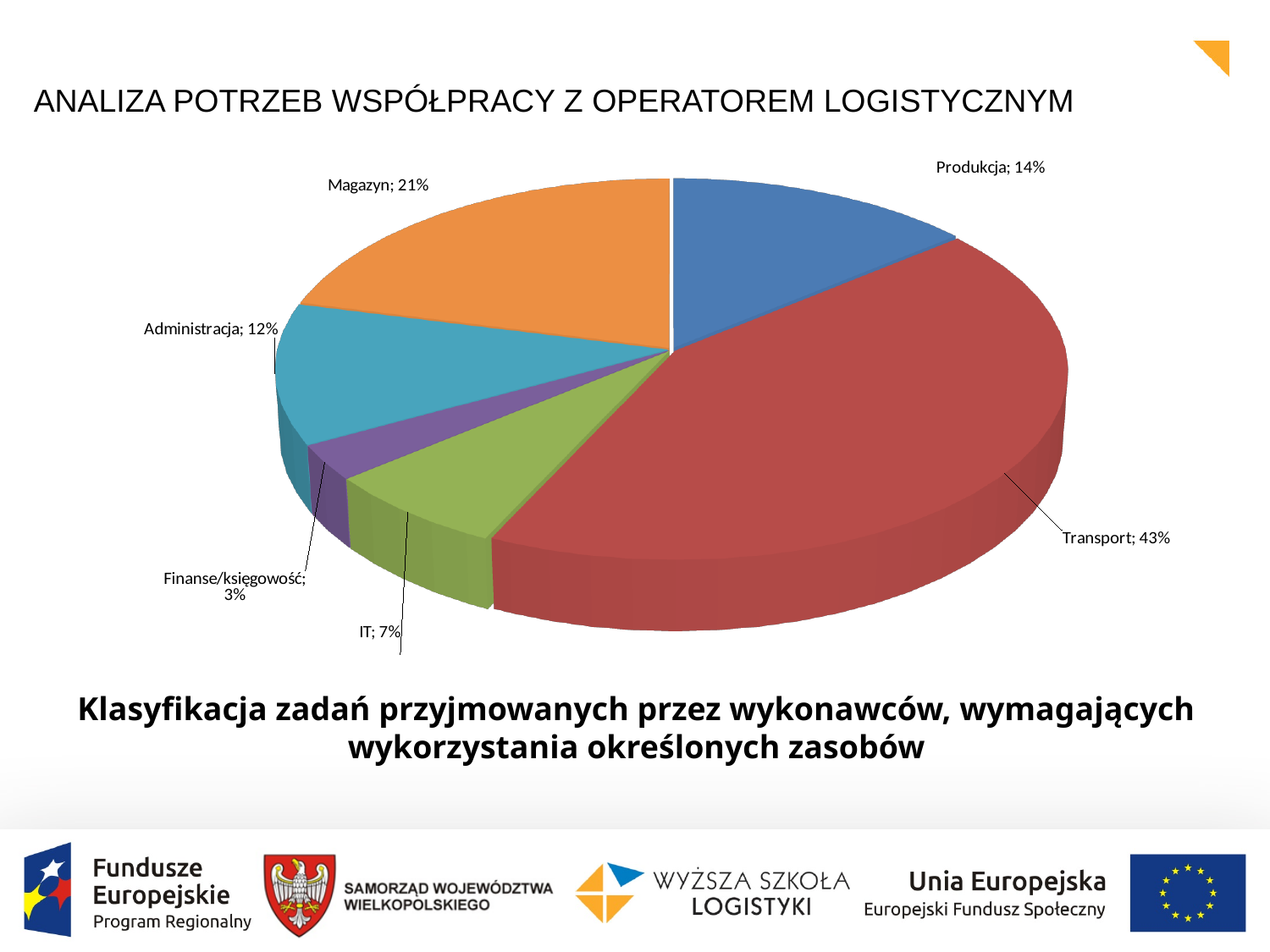
What is the value shown for Magazyn? 21% What colour is the Transport slice? Red What share of the pie does Transport have? 43% What percentage is shown for Finanse/księgowość? 3% What kind of chart is shown on the slide? Pie chart What is the combined share of Produkcja and Magazyn? 35% Which category has the largest slice of the pie? Transport What is the difference in percentage points between Transport and Magazyn? 22 Which is larger, Produkcja or Administracja? Produkcja Which category has the smallest slice of the pie? Finanse/księgowość What is the value for IT? 7% How many categories are shown in the pie chart? 6